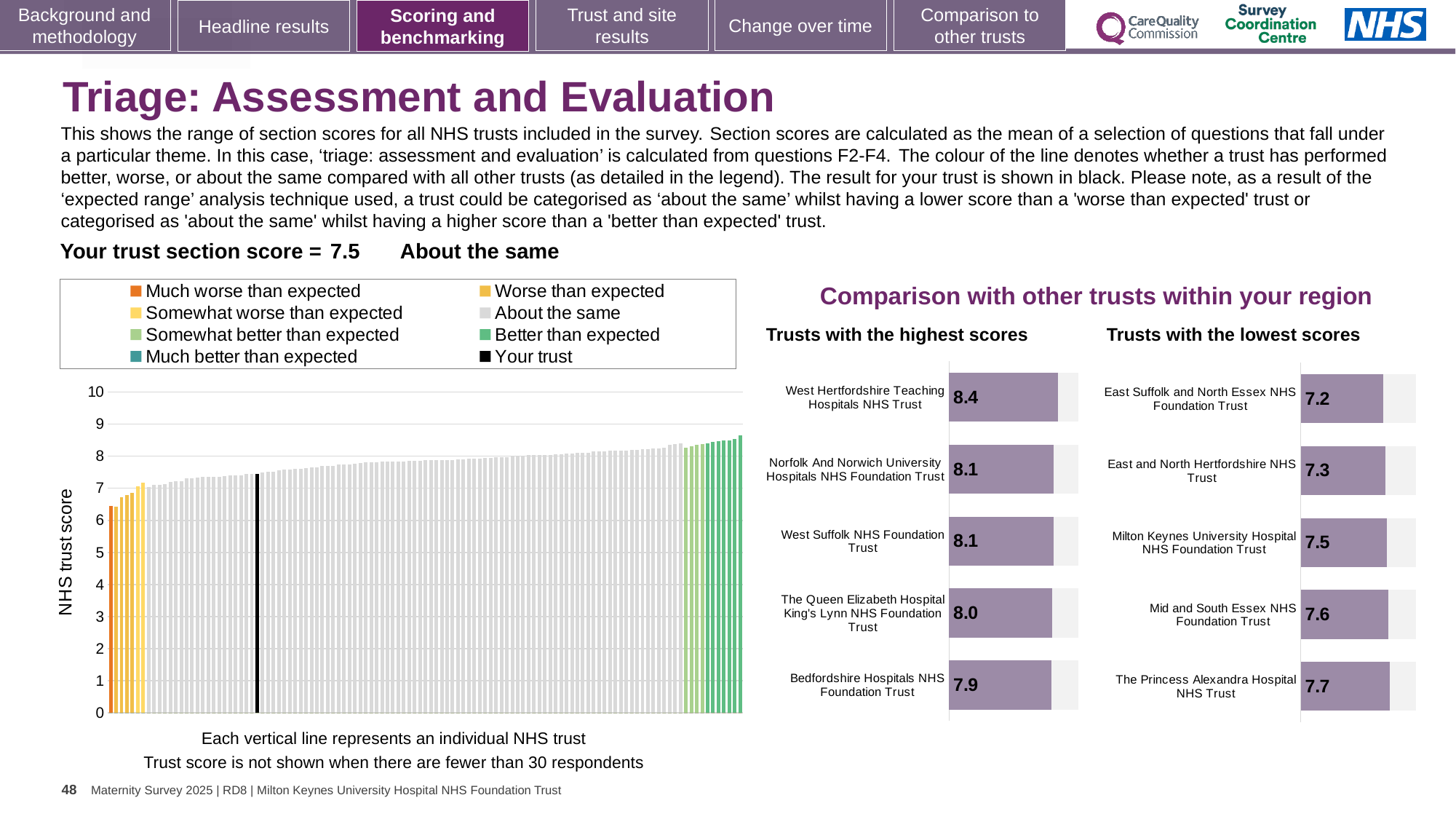
In the 'Trusts with the highest scores' chart, what is the score for West Hertfordshire Teaching Hospitals NHS Trust? 8.4 In the 'Trusts with the highest scores' chart, which trust has the highest score? West Hertfordshire Teaching Hospitals NHS Trust In the 'Trusts with the highest scores' chart, how many trusts are shown? 5 How many entries does the legend above the main chart on the left list? 8 What kind of chart is the main chart on the left showing all NHS trusts? bar chart In the 'Trusts with the lowest scores' chart, which trust has the lowest score? East Suffolk and North Essex NHS Foundation Trust In the 'Trusts with the lowest scores' chart, what is the score for Milton Keynes University Hospital NHS Foundation Trust? 7.5 In the 'Trusts with the lowest scores' chart, what is the score for East Suffolk and North Essex NHS Foundation Trust? 7.2 In the main chart on the left showing all NHS trusts, do the bar values rise or fall from left to right? rise In the main chart on the left showing all NHS trusts, is the value for the black bar (your trust) greater or less than 7? greater In the 'Trusts with the highest scores' chart, what is the difference between the scores of West Hertfordshire Teaching Hospitals NHS Trust and Bedfordshire Hospitals NHS Foundation Trust? 0.5 In the 'Trusts with the lowest scores' chart, which has the larger score: Mid and South Essex NHS Foundation Trust or East and North Hertfordshire NHS Trust? Mid and South Essex NHS Foundation Trust